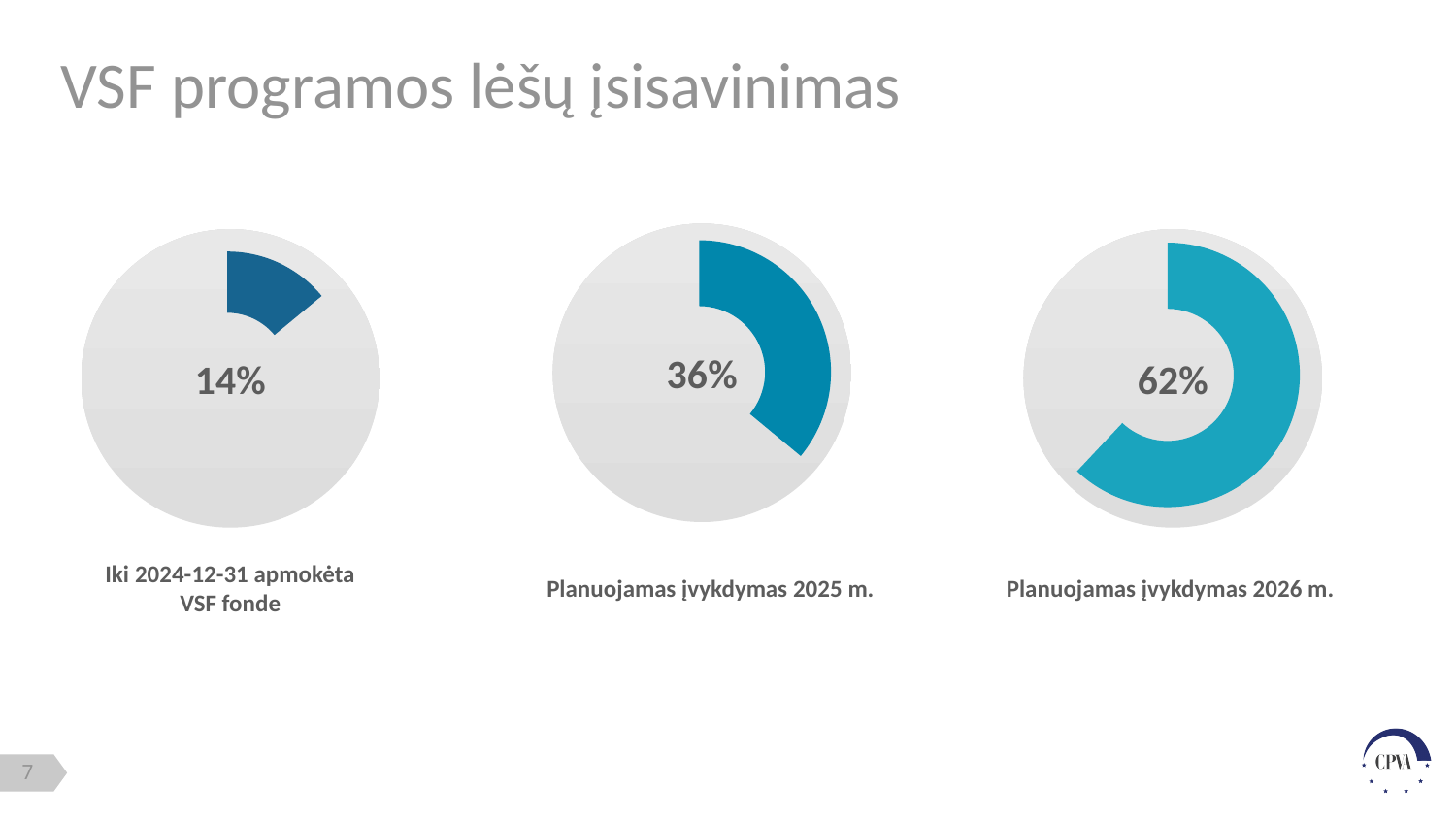
Which of the three charts on the slide shows the highest percentage? Planuojamas įvykdymas 2026 m. Which of the three charts on the slide shows the lowest percentage? Iki 2024-12-31 apmokėta VSF fonde What is the difference between the percentage on the "Planuojamas įvykdymas 2025 m." chart and the "Iki 2024-12-31 apmokėta VSF fonde" chart? 22% What is the title of the slide? VSF programos lėšų įsisavinimas What percentage is shown on the left chart labelled "Iki 2024-12-31 apmokėta VSF fonde"? 14% What percentage is shown on the right chart labelled "Planuojamas įvykdymas 2026 m."? 62% What kind of chart is used for each of the three values on the slide? Donut chart Do the percentages rise or fall from the left chart to the right chart? Rise How many charts are shown on the slide? 3 What is the difference between the percentage on the "Planuojamas įvykdymas 2026 m." chart and the "Planuojamas įvykdymas 2025 m." chart? 26% What percentage is shown on the middle chart labelled "Planuojamas įvykdymas 2025 m."? 36% Which is larger: the percentage on the "Planuojamas įvykdymas 2025 m." chart or the "Iki 2024-12-31 apmokėta VSF fonde" chart? Planuojamas įvykdymas 2025 m.